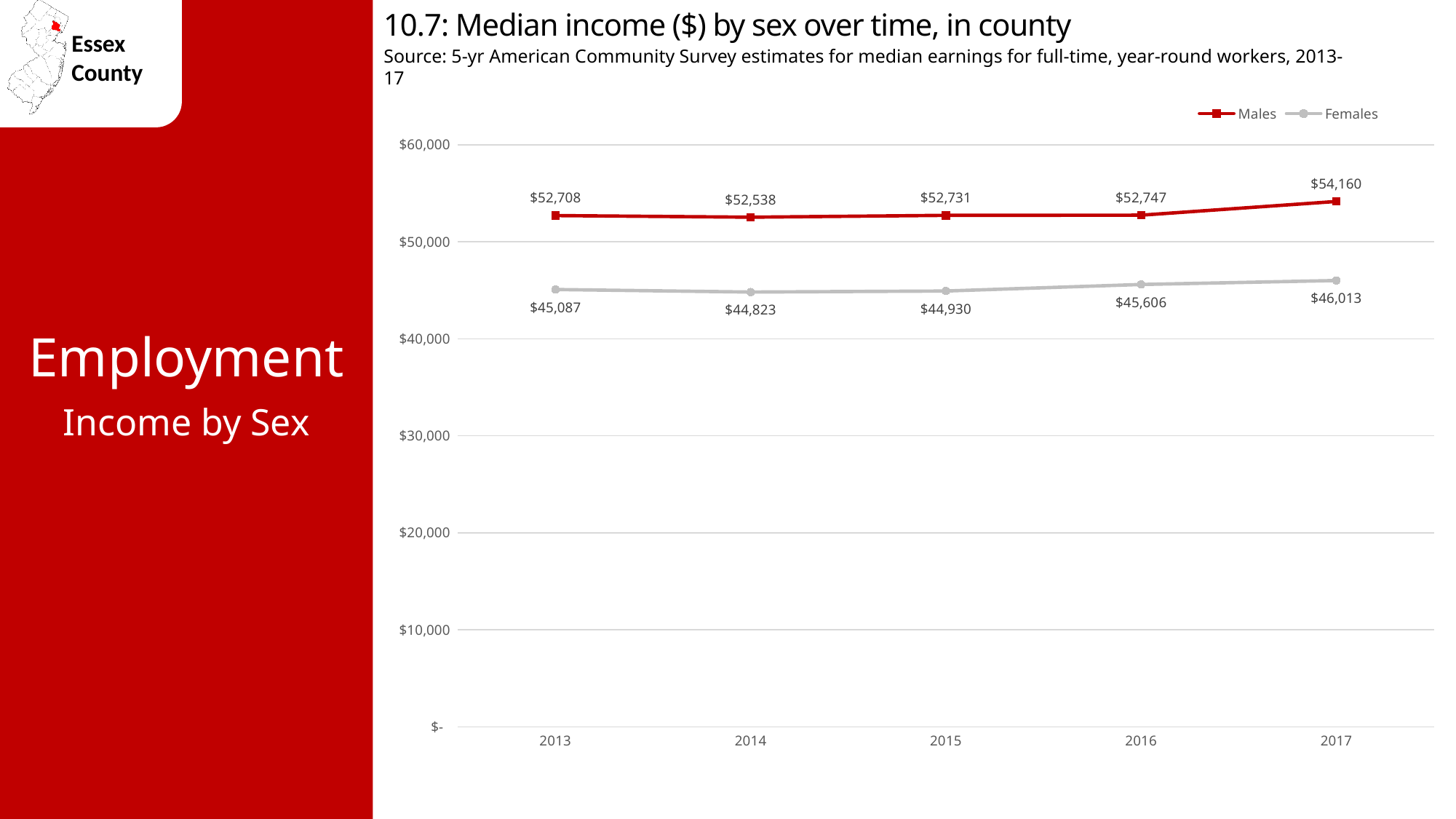
What is the difference between the Females median income in 2016 and 2015? $676 Which series had the higher median income in 2015, Males or Females? Males How many series does the legend list? 2 How many years are shown on the x axis? 5 What was the median income for Females in 2014? $44,823 In which year was the median income for Females the lowest? 2014 What is the difference between the Males and Females median income in 2017? $8,147 What kind of chart is shown on the slide? line chart What was the median income for Males in 2017? $54,160 In which year was the median income for Males the highest? 2017 Is the median income for Females in 2016 greater or less than $50,000? less What was the median income for Males in 2013? $52,708